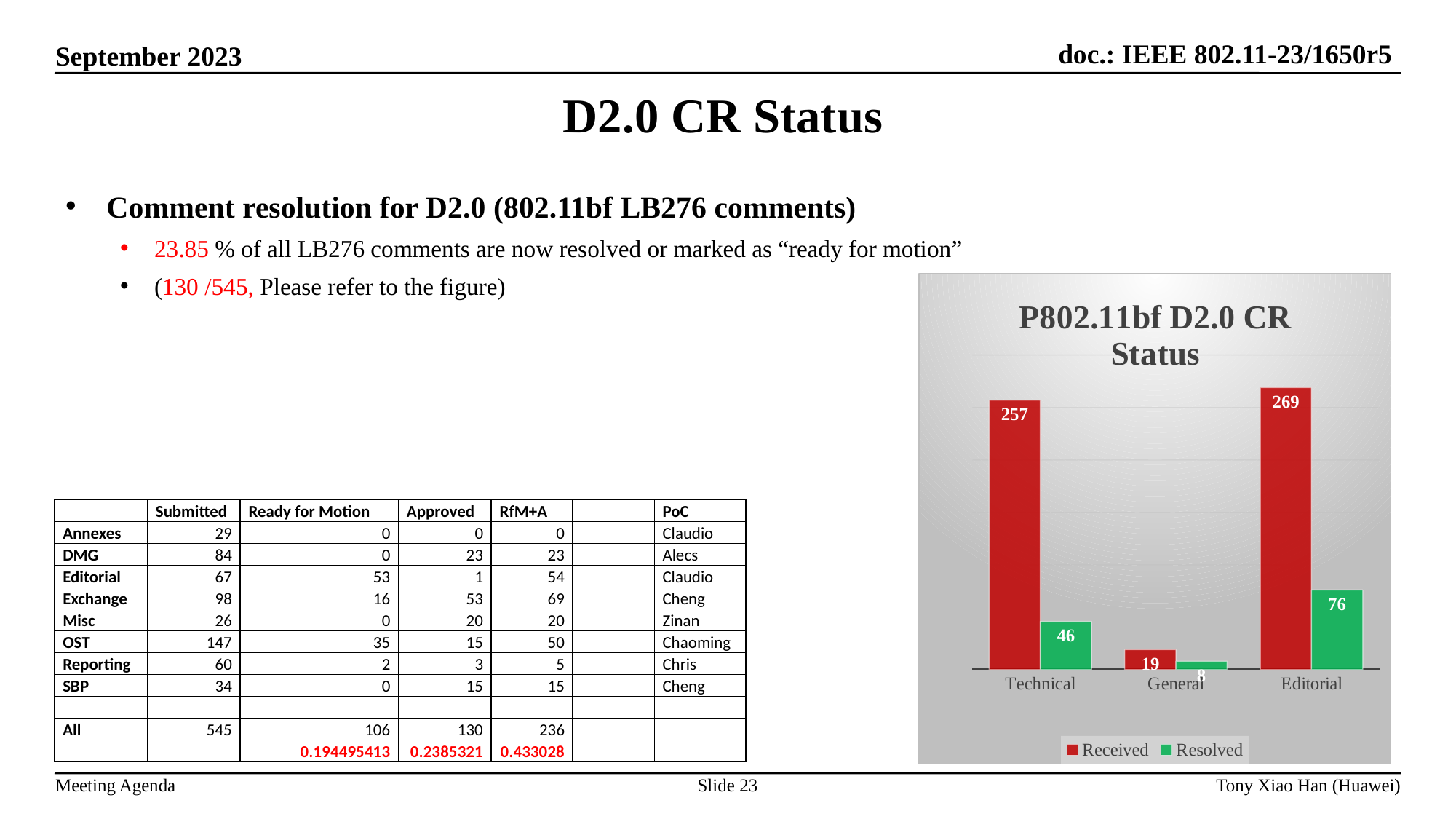
What is the title of the chart? P802.11bf D2.0 CR Status How many series does the chart legend list? 2 What is the Received value for Editorial? 269 What is the difference between the Received values for Editorial and Technical? 12 What is the Resolved value for Technical? 46 What is the Resolved value for Editorial? 76 What is the Received value for General? 19 Which category has the highest Received value? Editorial How many categories are shown on the x axis of the chart? 3 What is the Received value for Technical? 257 What kind of chart is shown on the slide? bar chart Which category has the lowest Received value? General